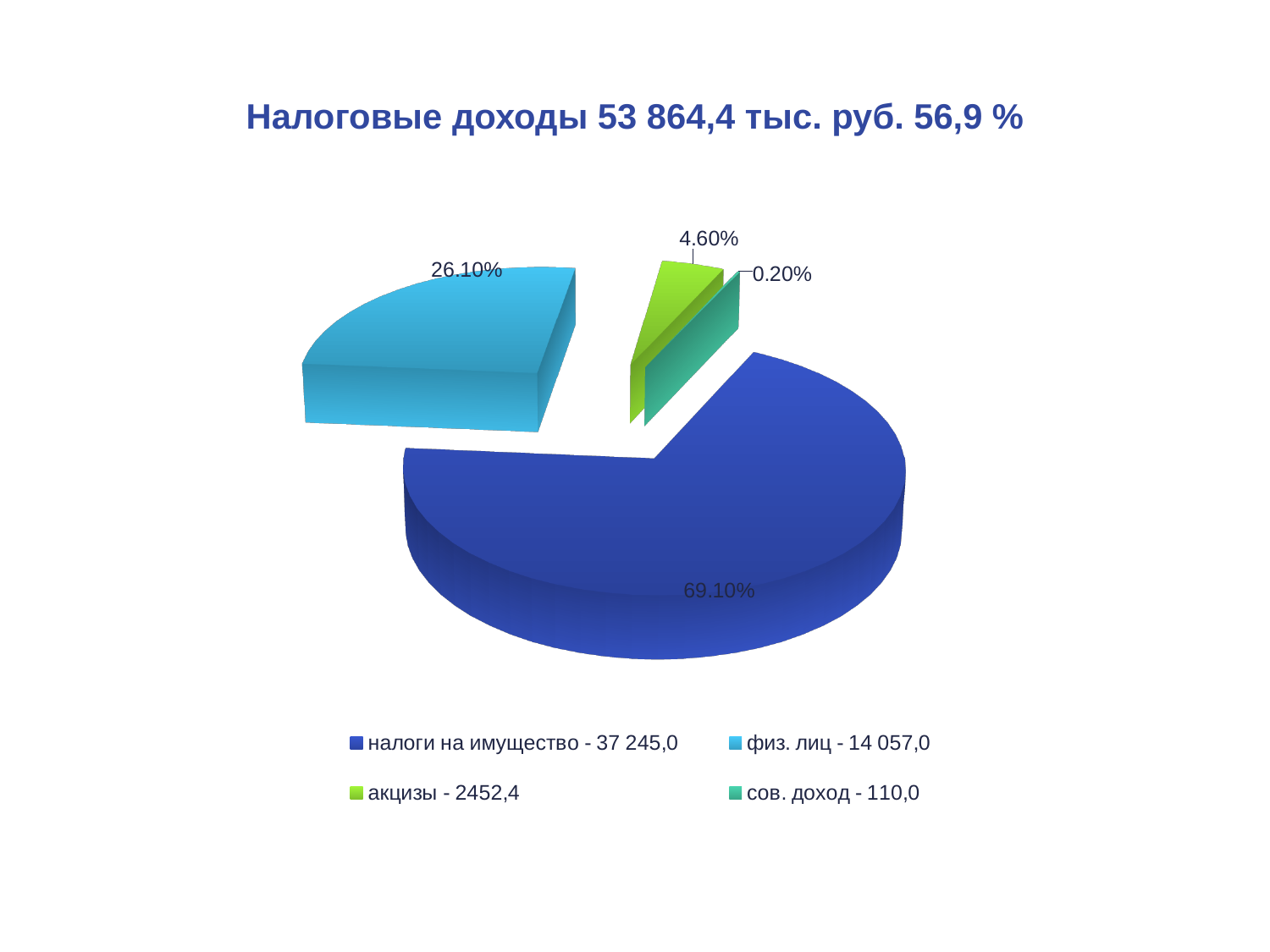
Which slice is the smallest in the pie chart? сов. доход How many slices does the pie chart have? 4 Which is larger, the 'физ. лиц' slice or the 'акцизы' slice? физ. лиц What share of the pie does the slice 'физ. лиц' represent? 26.10% What is the title of the chart? Налоговые доходы 53 864,4 тыс. руб. 56,9 % What percentage is shown for the 'акцизы' slice? 4.60% What kind of chart is shown on the slide? pie chart What share of the pie does the slice 'налоги на имущество' represent? 69.10% Which slice is the largest in the pie chart? налоги на имущество What is the difference in percentage points between the 'налоги на имущество' slice and the 'физ. лиц' slice? 43.00% What value is given for 'акцизы' in the legend? 2452,4 What percentage is shown for the 'сов. доход' slice? 0.20%